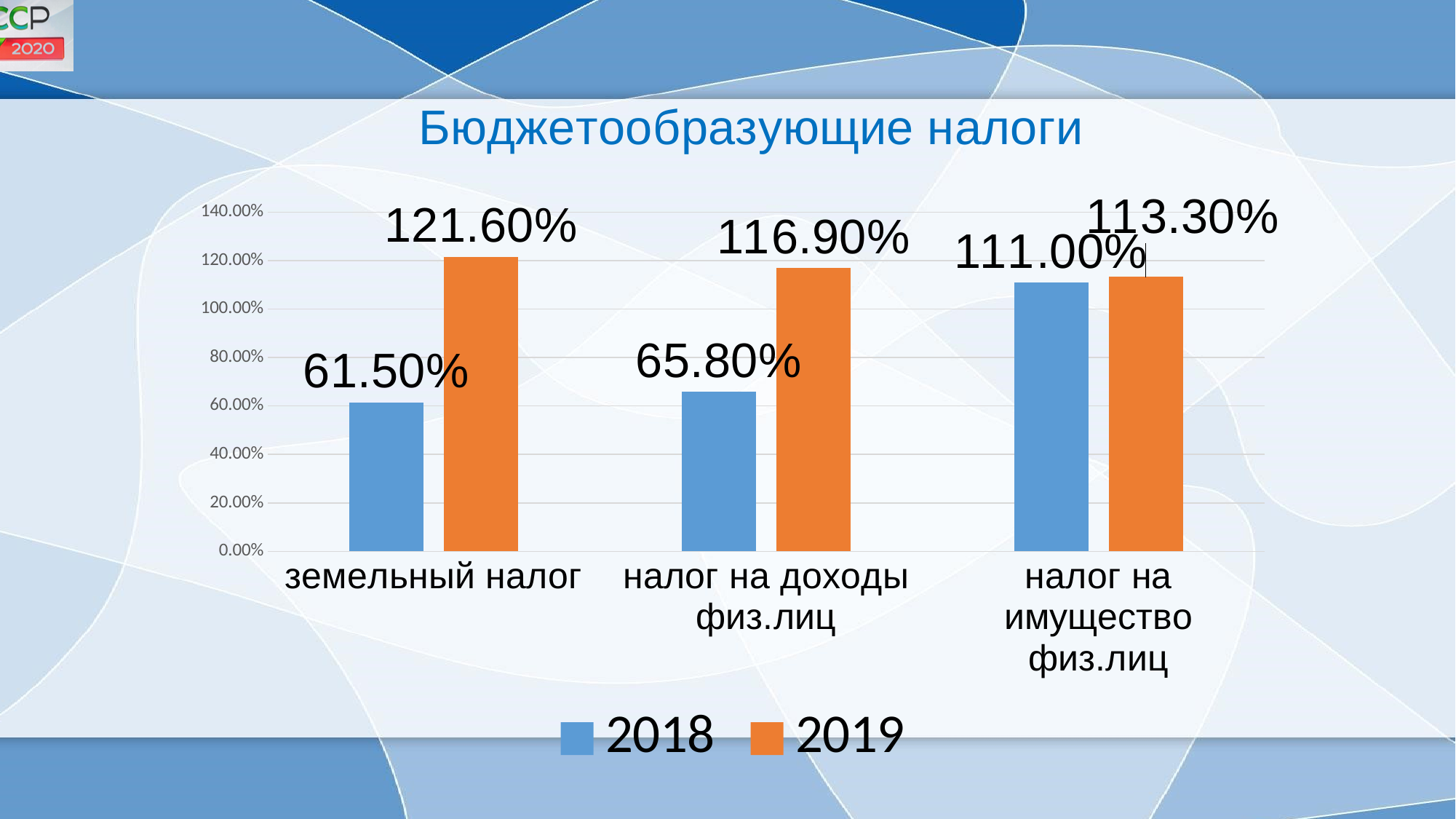
What type of chart is shown on the slide? bar chart What is the 2018 value for налог на доходы физ.лиц? 65.80% Is the 2018 value for налог на имущество физ.лиц greater or less than 100.00%? greater Which category has the lowest 2018 value? земельный налог What is the difference between the 2019 and 2018 values for земельный налог? 60.10% What is the 2018 value for налог на имущество физ.лиц? 111.00% Which category has the highest 2019 value? земельный налог How many categories are shown on the x axis? 3 Which is larger for налог на доходы физ.лиц: the 2018 value or the 2019 value? 2019 What is the 2019 value for налог на имущество физ.лиц? 113.30% How many series does the legend list? 2 What is the 2019 value for земельный налог? 121.60%